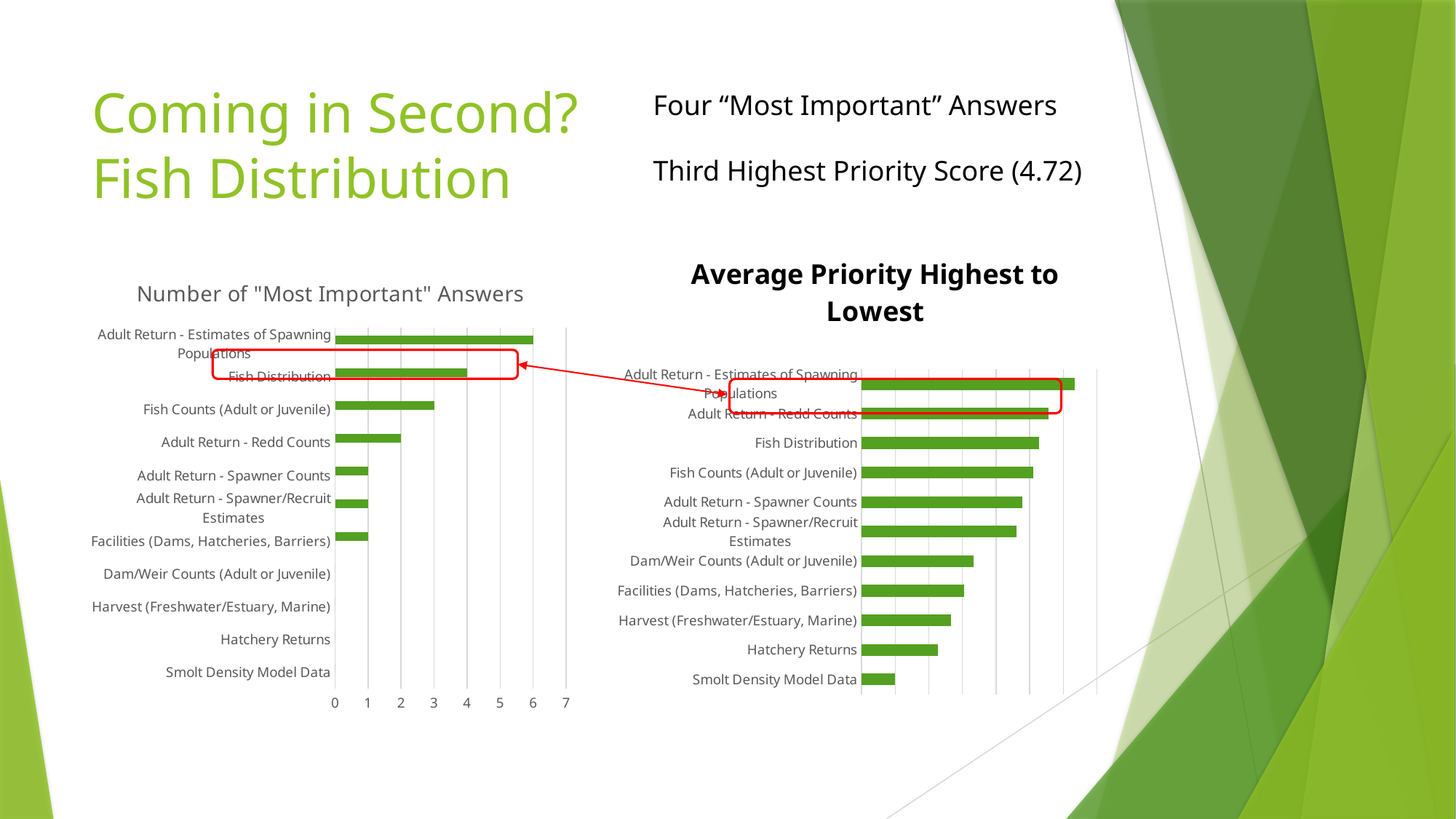
In the left chart "Number of "Most Important" Answers", what is the value for Adult Return - Estimates of Spawning Populations? 6 In the left chart "Number of "Most Important" Answers", which category has the highest value? Adult Return - Estimates of Spawning Populations In the right chart "Average Priority Highest to Lowest", which category has the highest value? Adult Return - Estimates of Spawning Populations In the right chart "Average Priority Highest to Lowest", which category has the lowest value? Smolt Density Model Data How many categories are listed in the left chart "Number of "Most Important" Answers"? 11 In the right chart "Average Priority Highest to Lowest", which is larger: Fish Distribution or Hatchery Returns? Fish Distribution In the left chart "Number of "Most Important" Answers", what is the value for Adult Return - Redd Counts? 2 In the left chart "Number of "Most Important" Answers", what is the value for Fish Distribution? 4 In the left chart "Number of "Most Important" Answers", what is the value for Fish Counts (Adult or Juvenile)? 3 In the left chart "Number of "Most Important" Answers", which is larger: Fish Counts (Adult or Juvenile) or Adult Return - Redd Counts? Fish Counts (Adult or Juvenile) What kind of chart is the left chart titled "Number of "Most Important" Answers"? Bar chart In the left chart "Number of "Most Important" Answers", what is the difference between Adult Return - Estimates of Spawning Populations and Fish Distribution? 2